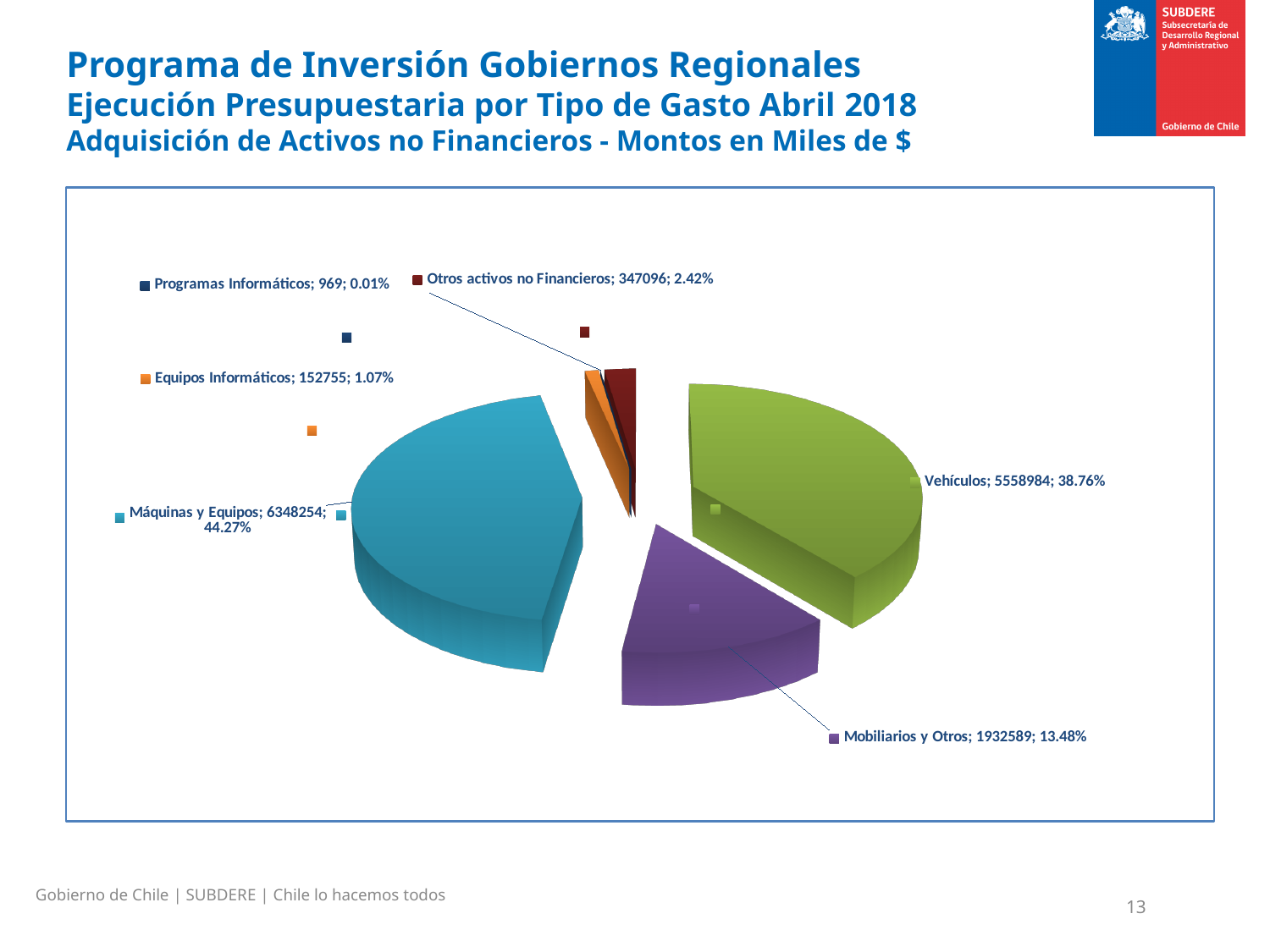
What is the difference between the values for Máquinas y Equipos and Vehículos? 789270 What is the value for Otros activos no Financieros? 347096 What is the value for Programas Informáticos? 969 What is the value for Vehículos? 5558984 What share of the pie does Equipos Informáticos represent? 1.07% What is the value for Mobiliarios y Otros? 1932589 How many categories are shown in the pie chart? 6 What share of the pie does Vehículos represent? 38.76% Which is larger, the value for Mobiliarios y Otros or the value for Otros activos no Financieros? Mobiliarios y Otros What is the value for Máquinas y Equipos? 6348254 Which category has the largest slice of the pie? Máquinas y Equipos Which category has the smallest slice of the pie? Programas Informáticos